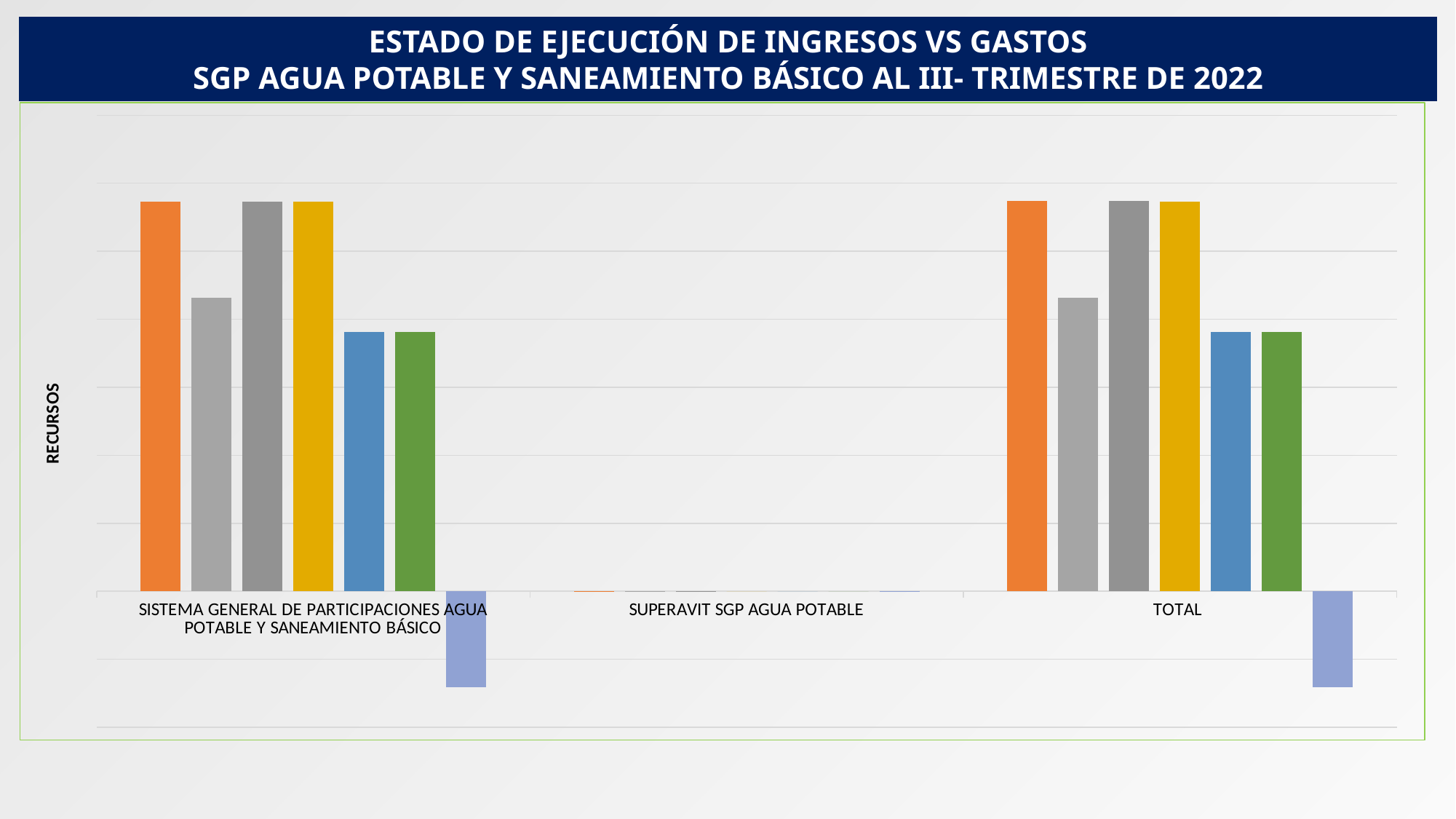
In the SISTEMA GENERAL DE PARTICIPACIONES AGUA POTABLE Y SANEAMIENTO BÁSICO category, is the light grey bar taller or shorter than the dark grey bar? Shorter In the TOTAL category, is the orange bar taller or shorter than the blue bar? Taller How many categories are shown on the x axis of the chart? 3 Which category is shown in the middle of the x axis? SUPERAVIT SGP AGUA POTABLE What is the title of the chart on the slide? ESTADO DE EJECUCIÓN DE INGRESOS VS GASTOS SGP AGUA POTABLE Y SANEAMIENTO BÁSICO AL III- TRIMESTRE DE 2022 Which category is shown at the far right of the x axis? TOTAL What is the label on the vertical axis of the chart? RECURSOS What kind of chart is shown on the slide? Bar chart Which category has the smallest bars in the chart? SUPERAVIT SGP AGUA POTABLE